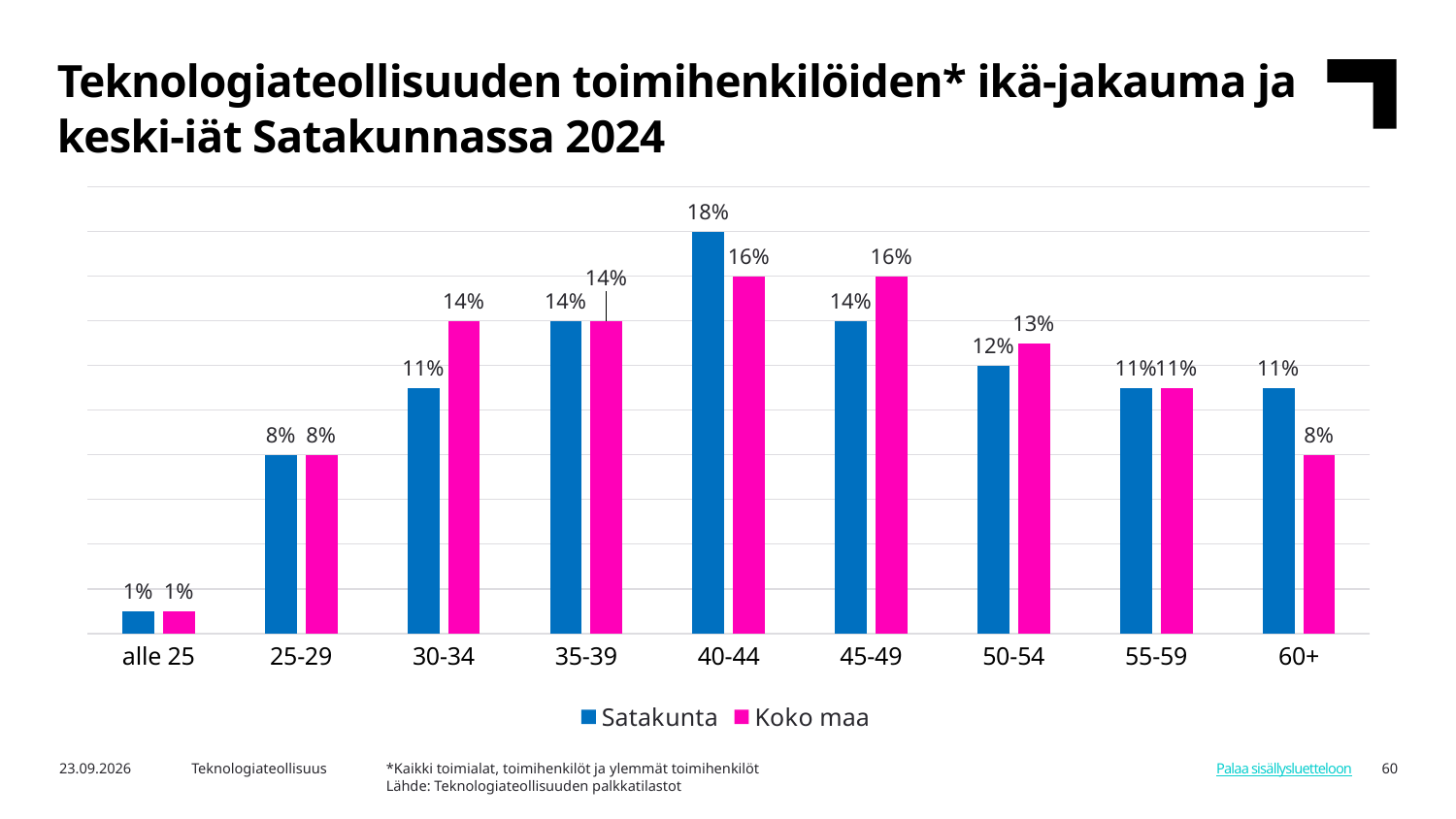
What kind of chart is shown on the slide? Bar chart How many age groups are shown on the x axis? 9 What is the value for Koko maa in the 60+ age group? 8% What is the value for Satakunta in the 40-44 age group? 18% Which age group has the highest value for Satakunta? 40-44 What is the value for Koko maa in the 50-54 age group? 13% Which age group has the lowest value for Koko maa? alle 25 What is the difference between Satakunta and Koko maa in the 30-34 age group? 3% What is the difference between Satakunta and Koko maa in the 60+ age group? 3% In the 45-49 age group, which series has the larger value, Satakunta or Koko maa? Koko maa How many series does the legend list? 2 Which series is shown in pink? Koko maa